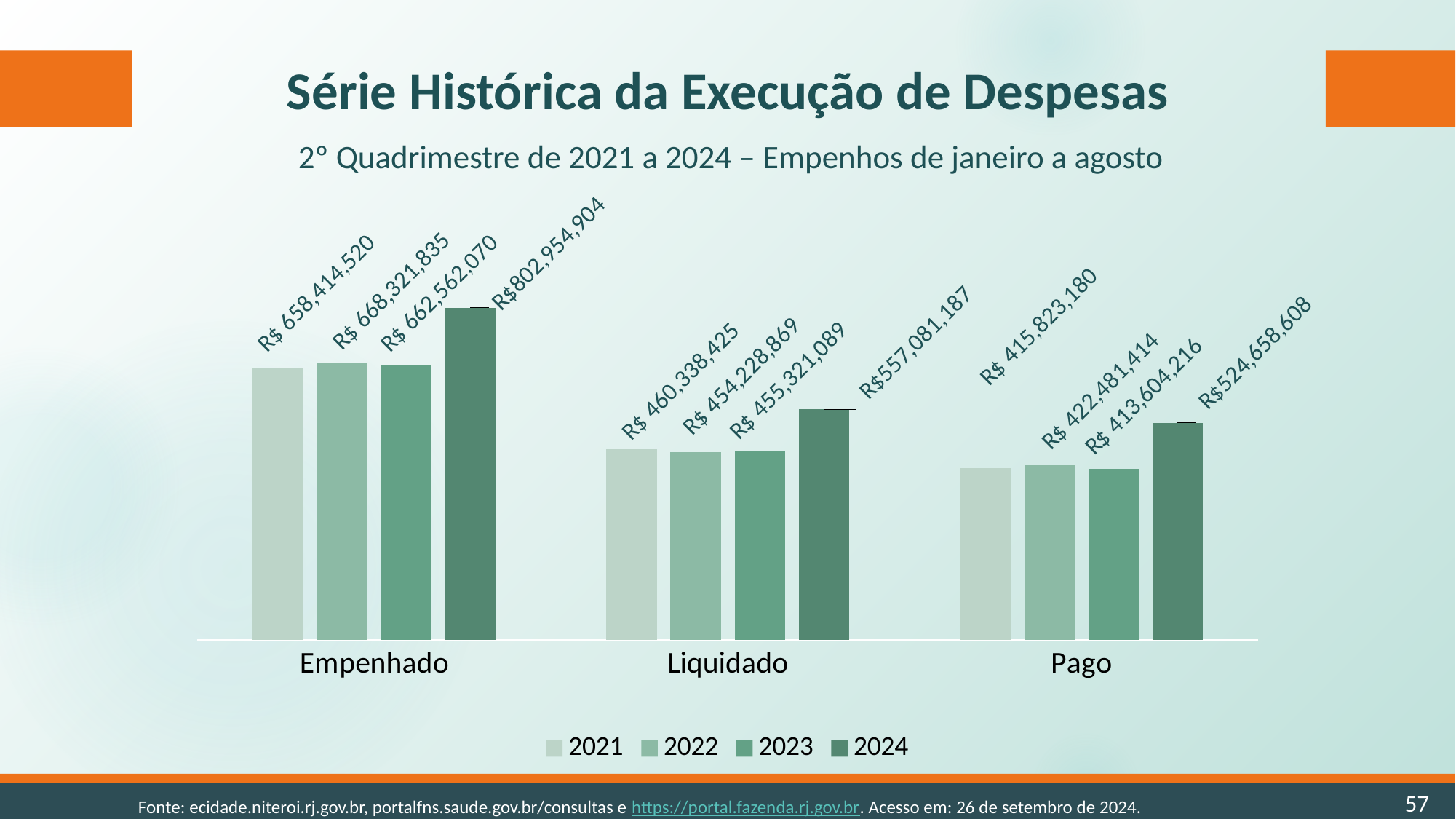
What is the difference between the 2024 and 2023 values in the Pago category? R$ 111,054,392 Which year has the lowest value in the Liquidado category? 2022 What is the value for 2023 in the Pago category? R$ 413,604,216 What is the value for 2021 in the Liquidado category? R$ 460,338,425 How many series does the legend list? 4 In the Empenhado category, which is larger: the value for 2022 or the value for 2023? 2022 What is the value for 2024 in the Empenhado category? R$802,954,904 What type of chart is shown on the slide? Bar chart What is the difference between the 2024 and 2021 values in the Empenhado category? R$ 144,540,384 What is the title of the chart on the slide? Série Histórica da Execução de Despesas How many categories are shown on the x axis? 3 Which year has the highest value in the Pago category? 2024